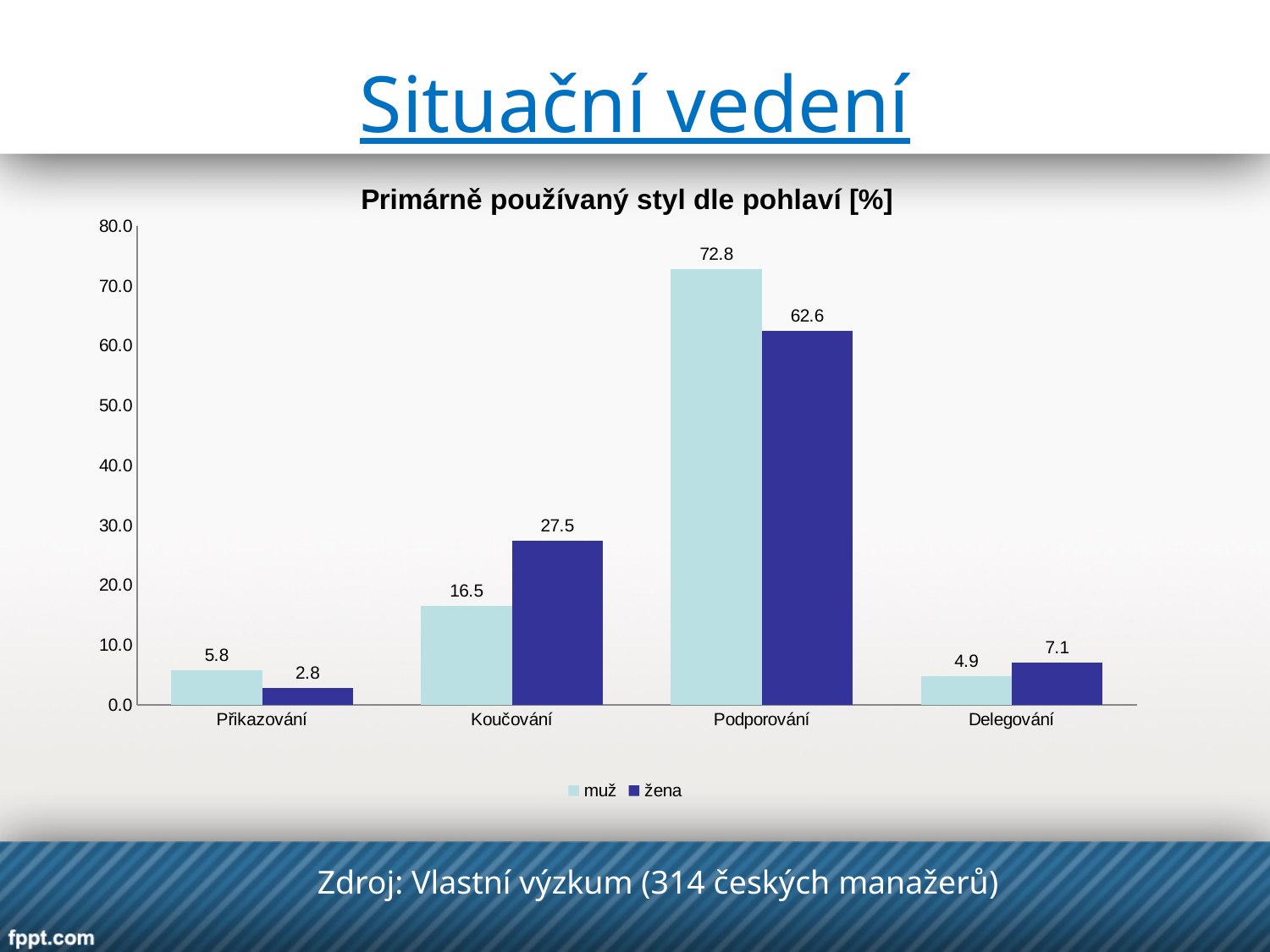
What is the title of the chart? Primárně používaný styl dle pohlaví [%] What is the value for muž in the Delegování category? 4.9 What is the difference between the muž and žena values in the Podporování category? 10.2 Which category has the lowest value for žena? Přikazování How many categories are shown on the x axis? 4 What kind of chart is shown on the slide? bar chart What is the value for žena in the Koučování category? 27.5 In the Koučování category, which is larger: muž or žena? žena Which category has the highest value for muž? Podporování How many series does the legend list? 2 What is the value for žena in the Přikazování category? 2.8 What is the value for muž in the Podporování category? 72.8